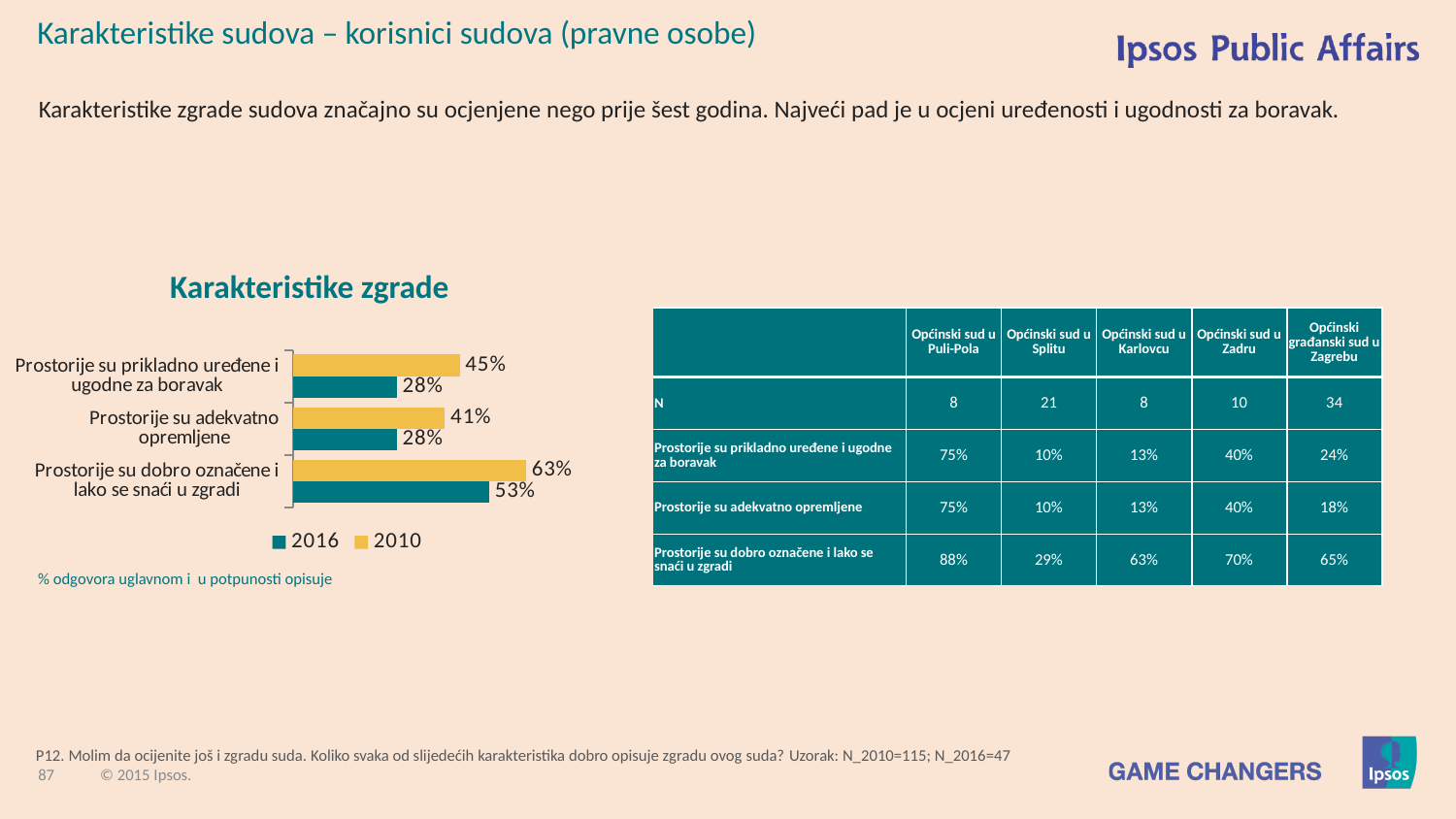
In the "Karakteristike zgrade" chart, what is the difference between the 2010 and 2016 values for "Prostorije su dobro označene i lako se snaći u zgradi"? 10% In the "Karakteristike zgrade" chart, what is the 2016 value for "Prostorije su dobro označene i lako se snaći u zgradi"? 53% In the "Karakteristike zgrade" chart, which colour represents the 2016 series? teal How many series does the legend of the "Karakteristike zgrade" chart list? 2 In the "Karakteristike zgrade" chart, which category has the lowest 2010 value? Prostorije su adekvatno opremljene In the "Karakteristike zgrade" chart, which is larger for "Prostorije su adekvatno opremljene": the 2016 value or the 2010 value? 2010 How many categories are shown in the "Karakteristike zgrade" chart? 3 In the "Karakteristike zgrade" chart, what is the 2010 value for "Prostorije su prikladno uređene i ugodne za boravak"? 45% What type of chart is "Karakteristike zgrade"? bar chart In the "Karakteristike zgrade" chart, what is the 2016 value for "Prostorije su adekvatno opremljene"? 28% In the "Karakteristike zgrade" chart, which category has the highest 2010 value? Prostorije su dobro označene i lako se snaći u zgradi In the "Karakteristike zgrade" chart, what is the difference between the 2010 and 2016 values for "Prostorije su prikladno uređene i ugodne za boravak"? 17%